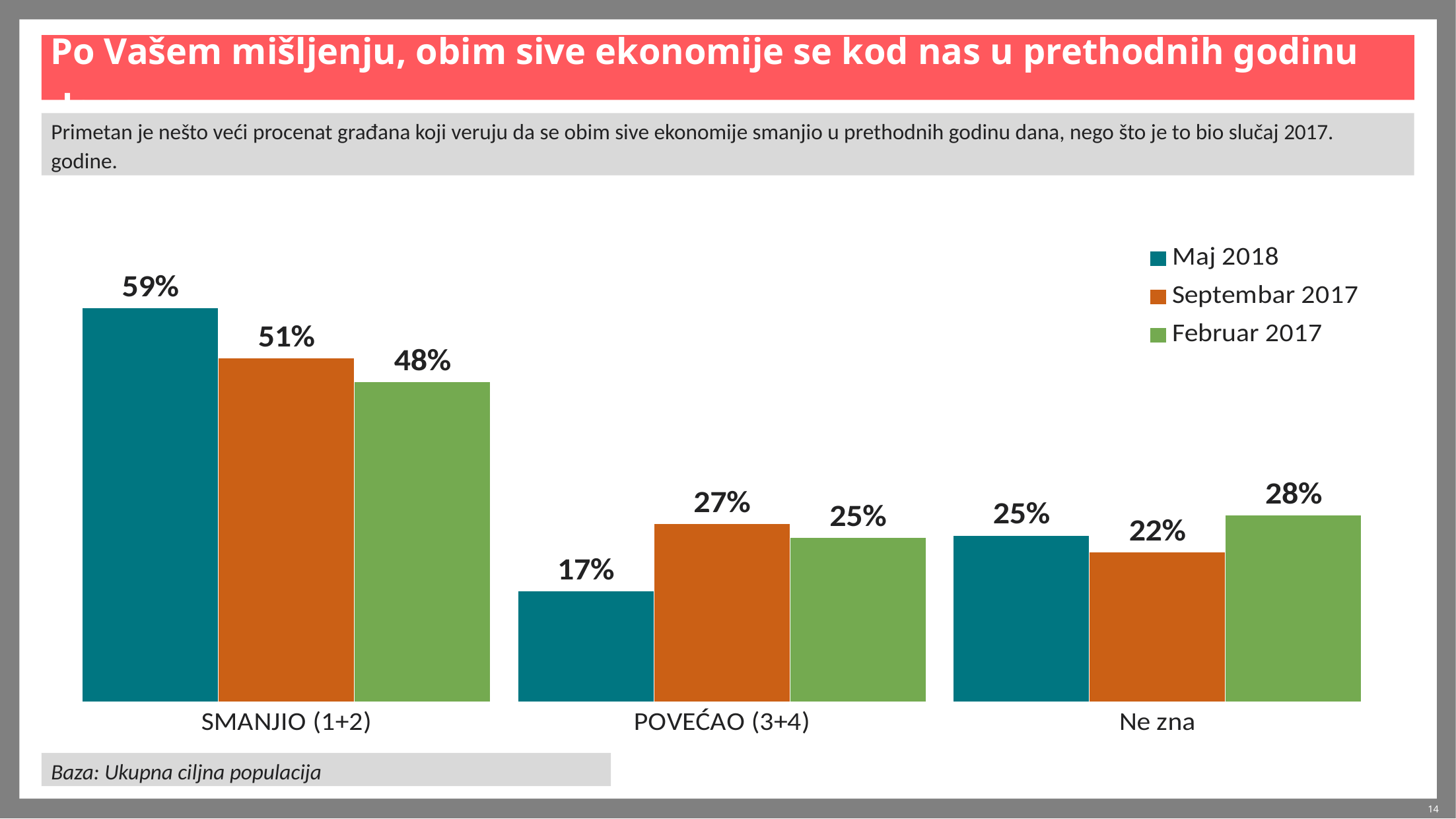
What is the value for Februar 2017 in the Ne zna category? 28% Which colour represents the Septembar 2017 series? Orange Which is larger in the Ne zna category: Maj 2018 or Septembar 2017? Maj 2018 What is the difference between the Maj 2018 and Februar 2017 values in the SMANJIO (1+2) category? 11% Which series has the highest value in the SMANJIO (1+2) category? Maj 2018 What is the value for Maj 2018 in the SMANJIO (1+2) category? 59% How many categories are shown on the x axis? 3 What kind of chart is shown on the slide? Bar chart How many series does the legend list? 3 What is the value for Septembar 2017 in the POVEĆAO (3+4) category? 27% What is the difference between the Septembar 2017 and Maj 2018 values in the POVEĆAO (3+4) category? 10% Which series has the lowest value in the POVEĆAO (3+4) category? Maj 2018